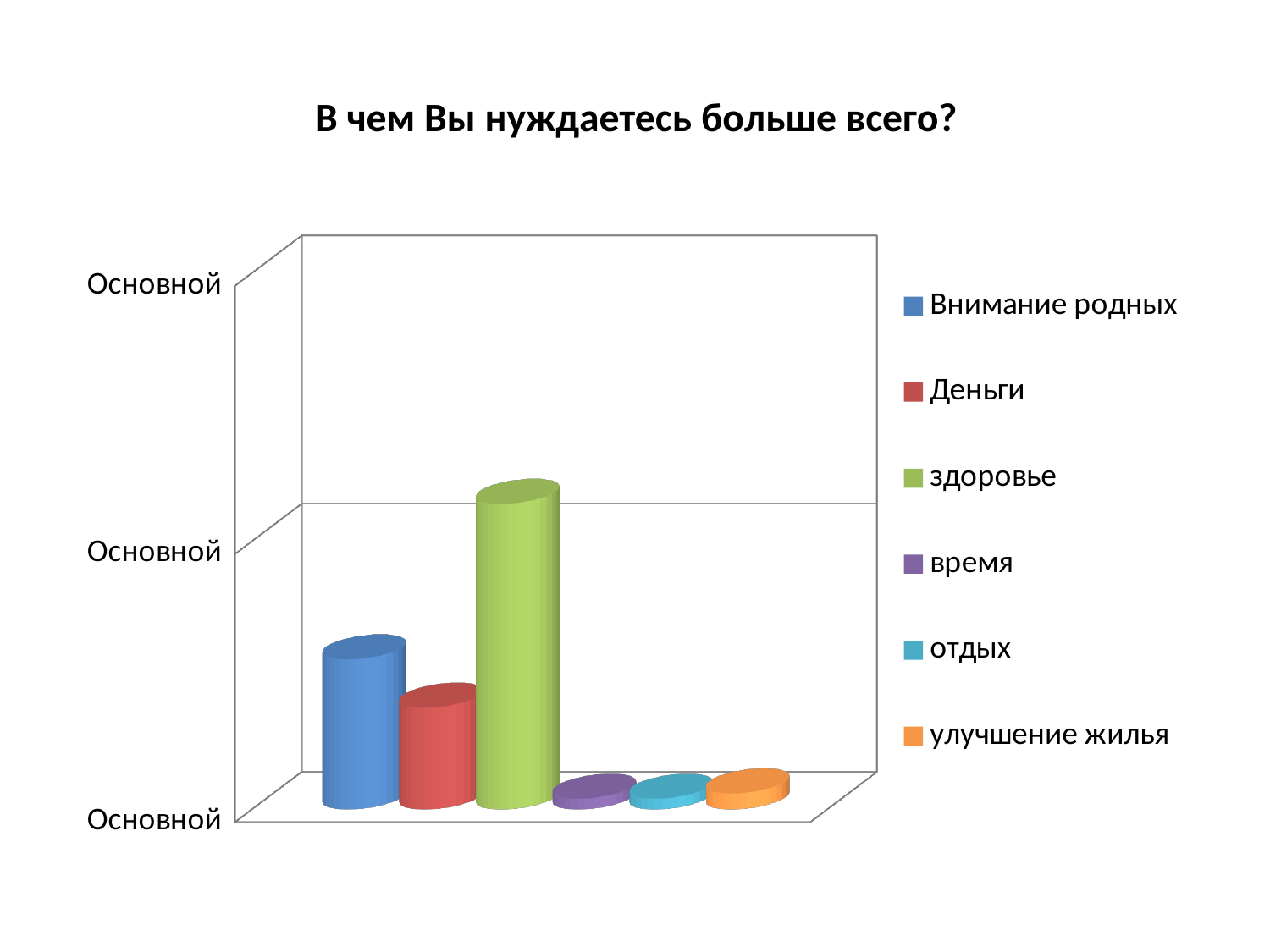
Which is larger, the value for здоровье or the value for Внимание родных? здоровье How many bars are plotted in the chart? 6 Which is larger, the value for здоровье or the value for улучшение жилья? здоровье How many entries does the legend list? 6 Which is larger, the value for Деньги or the value for отдых? Деньги What colour is the bar for здоровье? green What is the title of the chart? В чем Вы нуждаетесь больше всего? Which category has the highest bar? здоровье What kind of chart is shown on the slide? bar chart